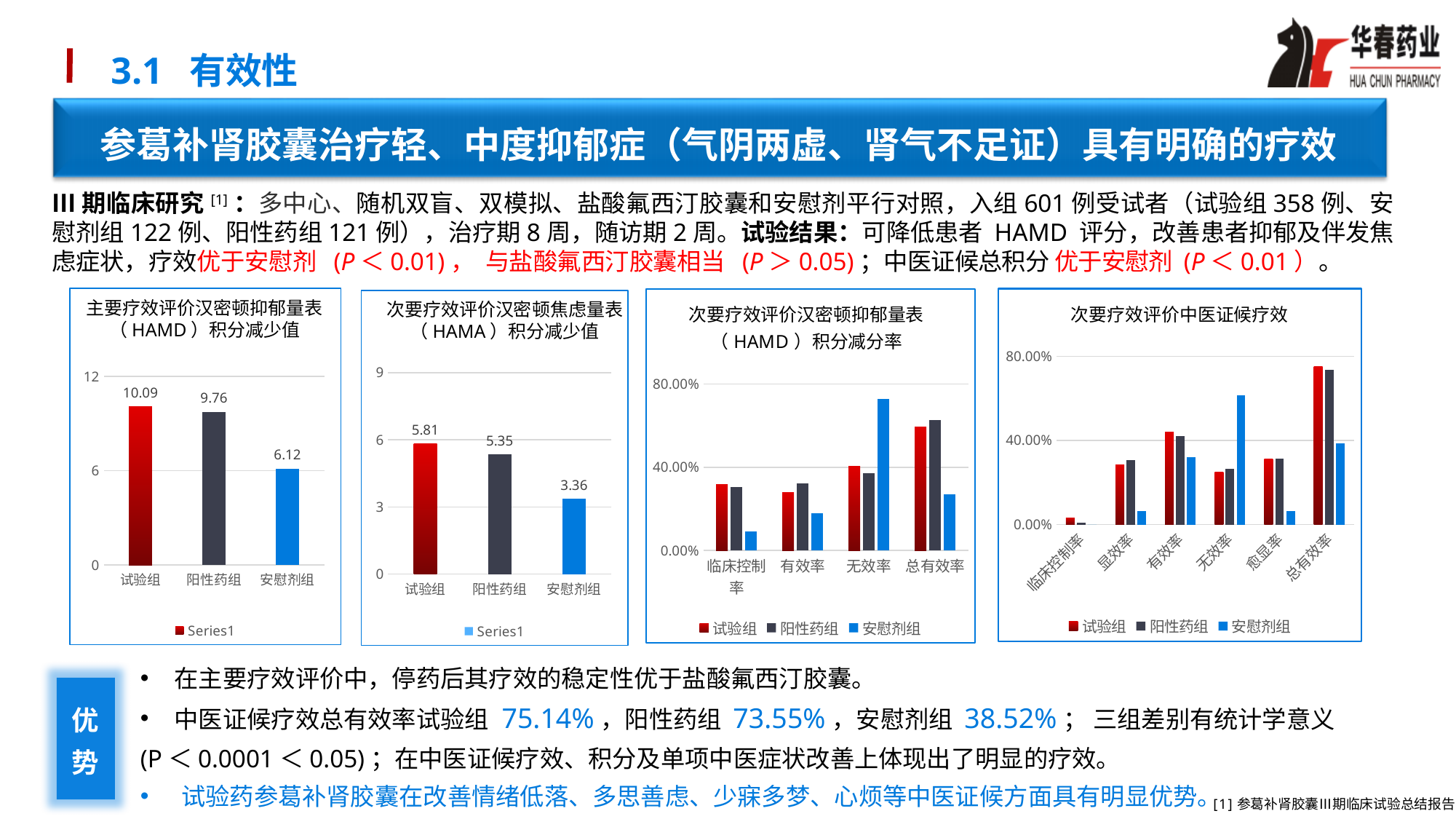
In the chart titled 次要疗效评价中医证候疗效, is the value for 试验组 at 总有效率 greater or less than 40.00%? greater In the chart titled 次要疗效评价汉密顿抑郁量表（HAMD）积分减分率, which group has the highest value at 无效率? 安慰剂组 In the chart titled 次要疗效评价汉密顿抑郁量表（HAMD）积分减分率, how many series does the legend list? 3 In the chart titled 次要疗效评价汉密顿焦虑量表（HAMA）积分减少值, what is the value for 阳性药组? 5.35 In the chart titled 主要疗效评价汉密顿抑郁量表（HAMD）积分减少值, what is the difference between 试验组 and 安慰剂组? 3.97 In the chart titled 次要疗效评价中医证候疗效, how many categories are shown on the x axis? 6 What kind of chart is the one titled 次要疗效评价中医证候疗效? bar chart In the chart titled 主要疗效评价汉密顿抑郁量表（HAMD）积分减少值, what is the value for 试验组? 10.09 In the chart titled 次要疗效评价汉密顿焦虑量表（HAMA）积分减少值, which group has the highest value? 试验组 In the chart titled 次要疗效评价汉密顿抑郁量表（HAMD）积分减分率, is the value for 安慰剂组 at 无效率 greater or less than 40.00%? greater In the chart titled 主要疗效评价汉密顿抑郁量表（HAMD）积分减少值, which group has the lowest value? 安慰剂组 In the chart titled 次要疗效评价汉密顿焦虑量表（HAMA）积分减少值, how many groups are shown on the x axis? 3